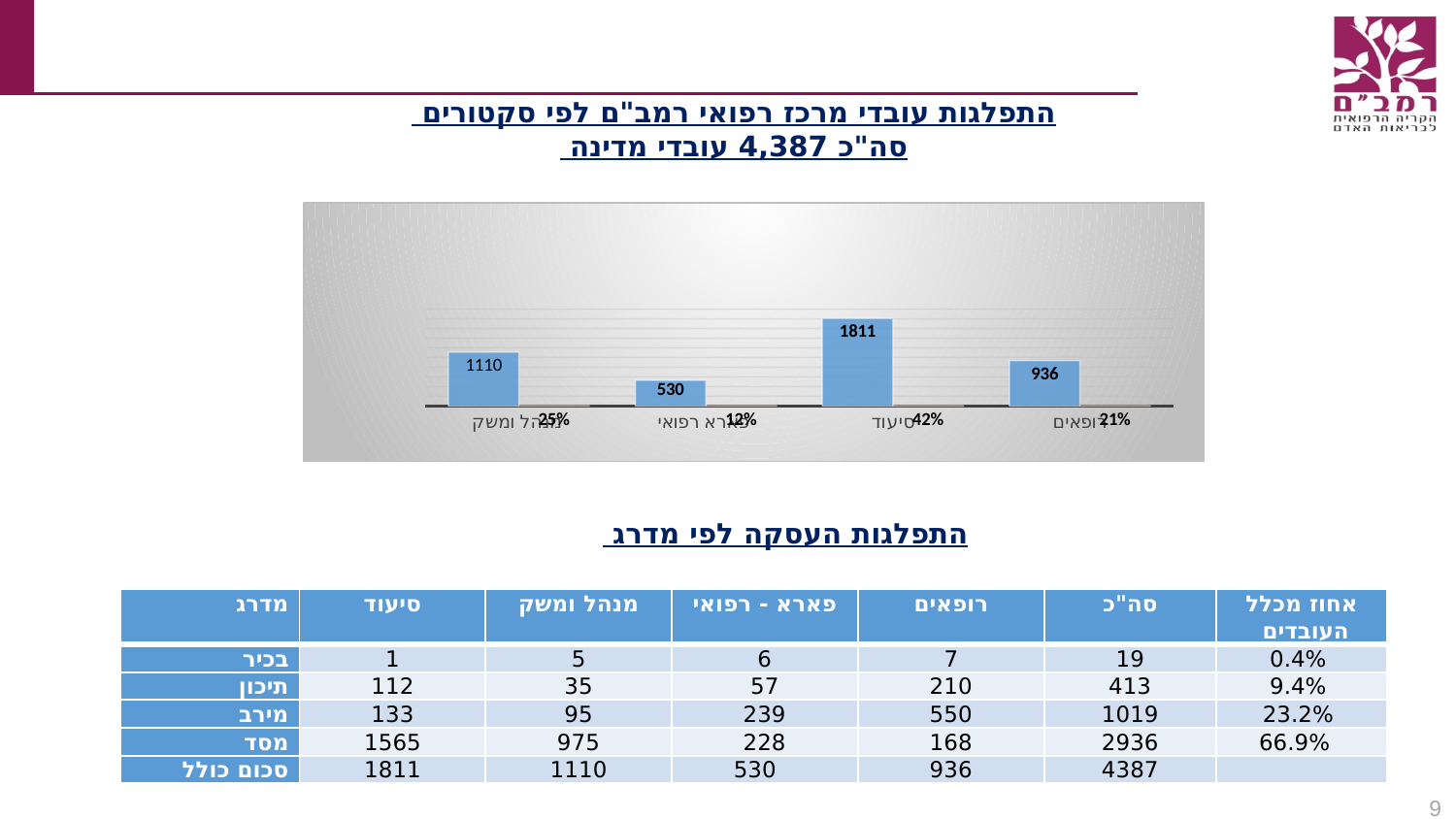
What is the difference between the values for סיעוד and רופאים in the bar chart? 875 What is the value shown for פארא רפואי in the bar chart? 530 What is the value shown for סיעוד in the bar chart? 1811 Which category has the lowest value in the bar chart? פארא רפואי What is the value shown for מנהל ומשק in the bar chart? 1110 What is the difference between the values for מנהל ומשק and פארא רפואי in the bar chart? 580 What is the value shown for רופאים in the bar chart? 936 Which is larger in the bar chart, the value for מנהל ומשק or the value for רופאים? מנהל ומשק What kind of chart is shown on the slide? bar chart What percentage label is shown for סיעוד in the bar chart? 42% How many categories are shown in the bar chart? 4 Which category has the highest value in the bar chart? סיעוד